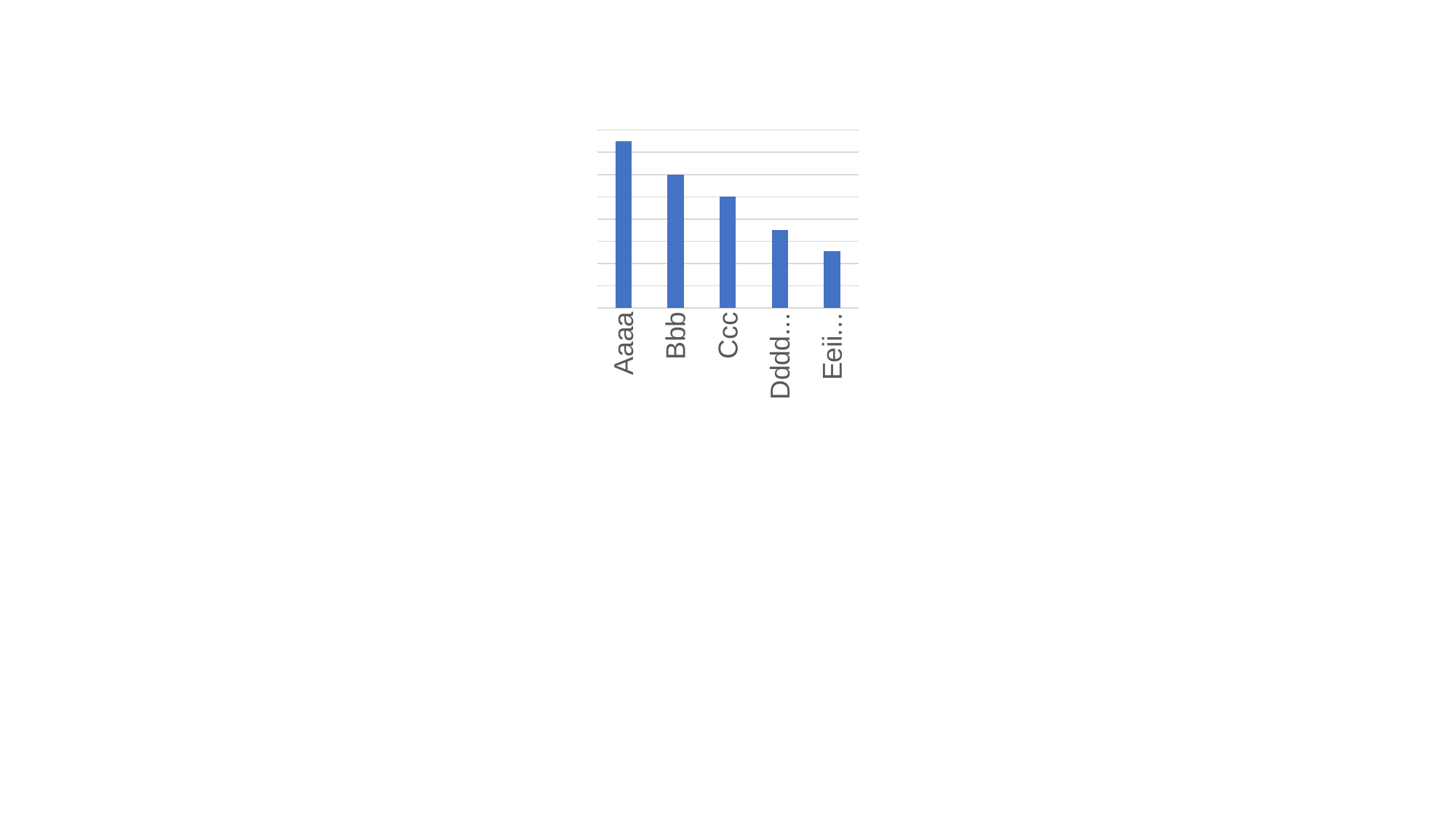
Which is larger, the value for Aaaa or the value for Ccc? Aaaa Which is larger, the value for Bbb or the value for Ccc? Bbb How many bars does the chart have? 5 Which is larger, the value for Aaaa or the value for Bbb? Aaaa Which category has the highest bar? Aaaa Do the bar values rise or fall from left to right along the x axis? fall What colour are the bars in the chart? blue What is the label of the first category on the x axis? Aaaa What kind of chart is shown on the slide? bar chart